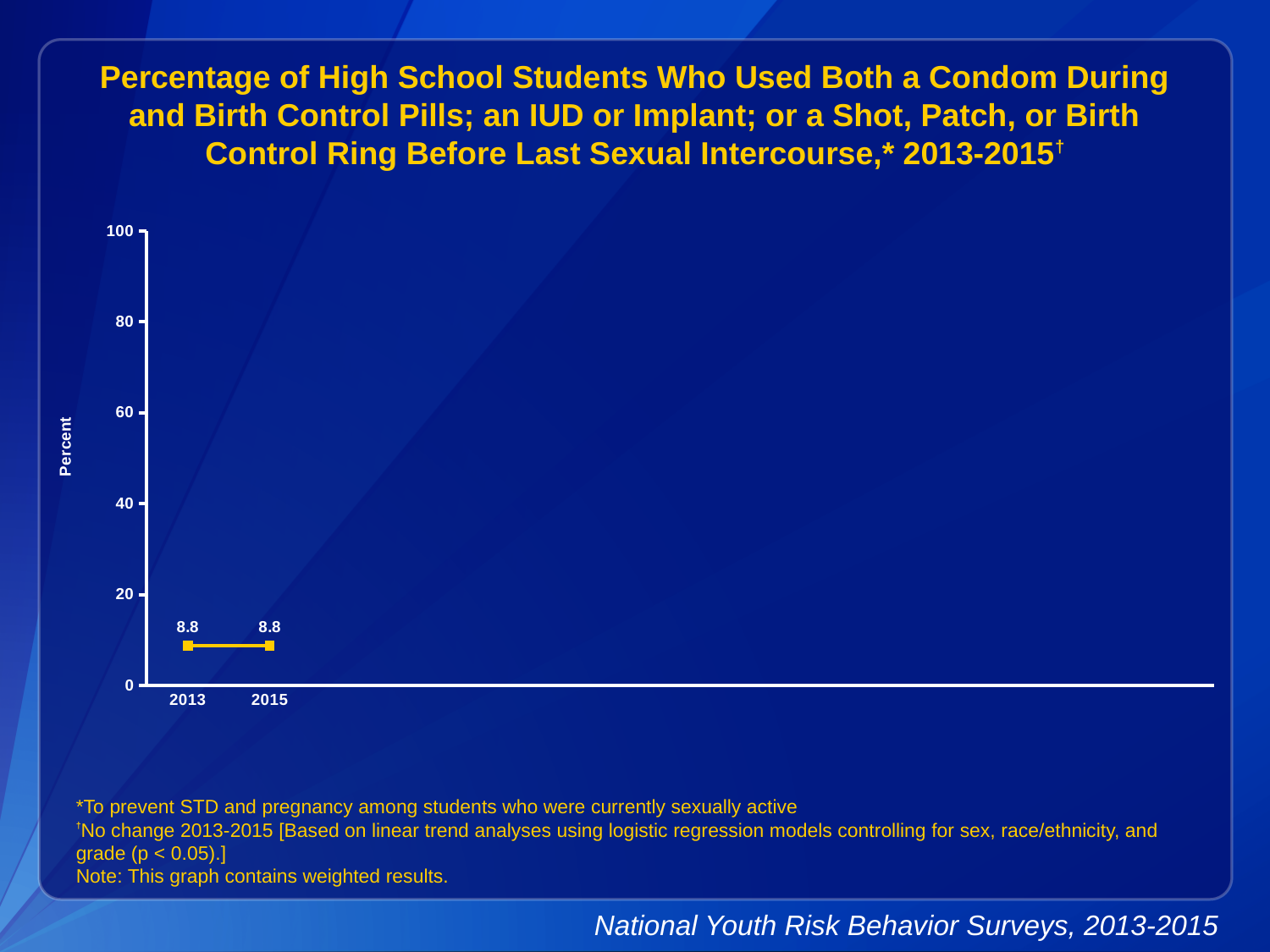
What is the value for 2013? 8.8 How many data points are plotted on the chart? 2 Do the values rise, fall, or stay the same from 2013 to 2015? stay the same What kind of chart is shown on the slide? line chart Is the value for 2015 greater or less than 20? less Is the value for 2013 greater or less than 40? less What is the maximum value shown on the y axis? 100 What is the difference between the values for 2013 and 2015? 0 What is the label of the y axis? Percent What is the value for 2015? 8.8